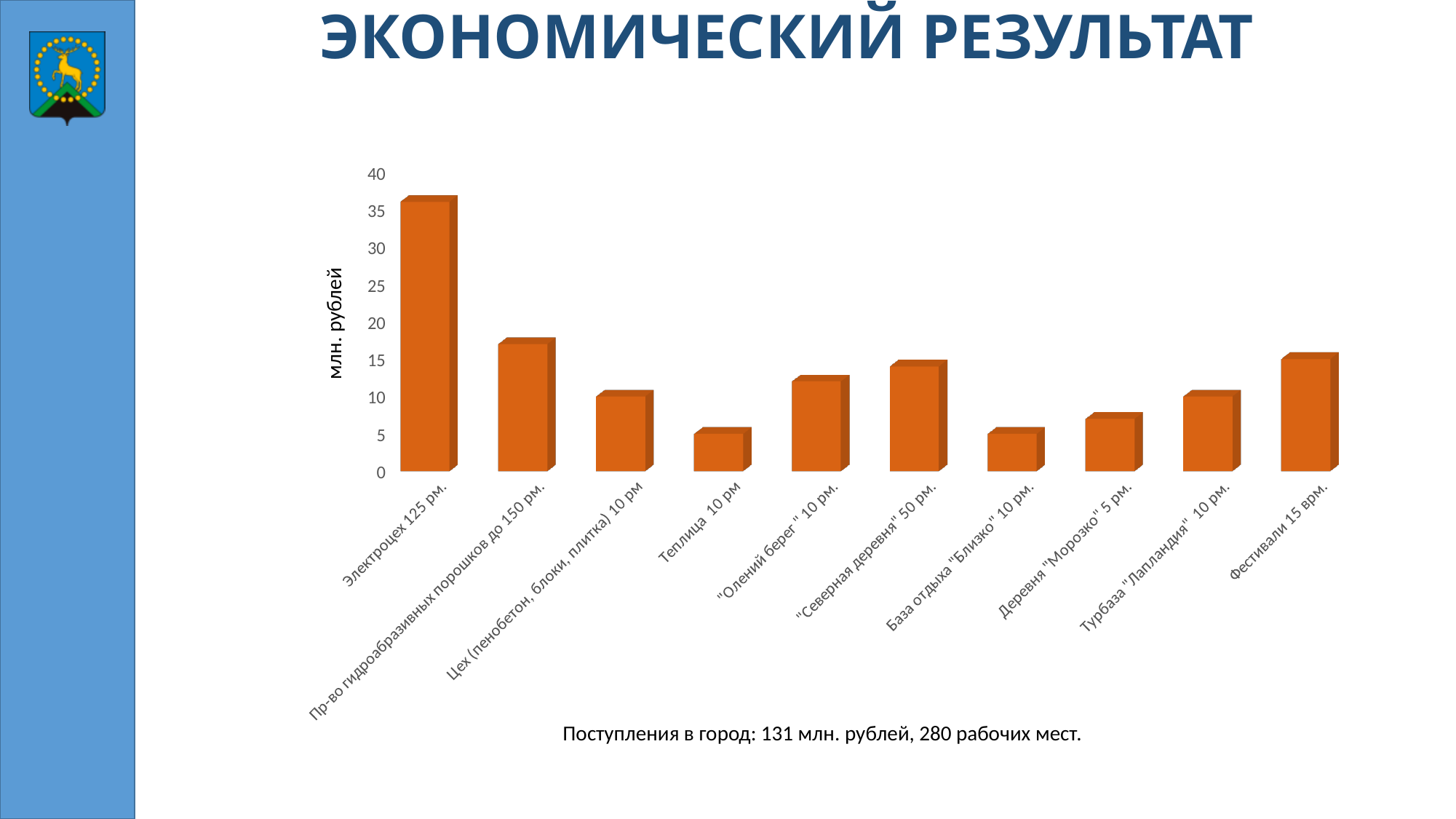
What is the title of the slide containing the chart? ЭКОНОМИЧЕСКИЙ РЕЗУЛЬТАТ Is the value for Электроцех 125 рм. greater or less than 30? greater How many categories are plotted on the chart? 10 Is the value for Пр-во гидроабразивных порошков до 150 рм. greater or less than 15? greater Is the value for Фестивали 15 врм. greater or less than 10? greater Which category has the highest value on the chart? Электроцех 125 рм. Which has a larger value: "Северная деревня" 50 рм. or Деревня "Морозко" 5 рм.? "Северная деревня" 50 рм. Which has a larger value: Электроцех 125 рм. or Фестивали 15 врм.? Электроцех 125 рм. What is the label of the vertical axis of the chart? млн. рублей What kind of chart is shown on the slide? bar chart Which has a larger value: "Олений берег" 10 рм. or База отдыха "Близко" 10 рм.? "Олений берег" 10 рм.